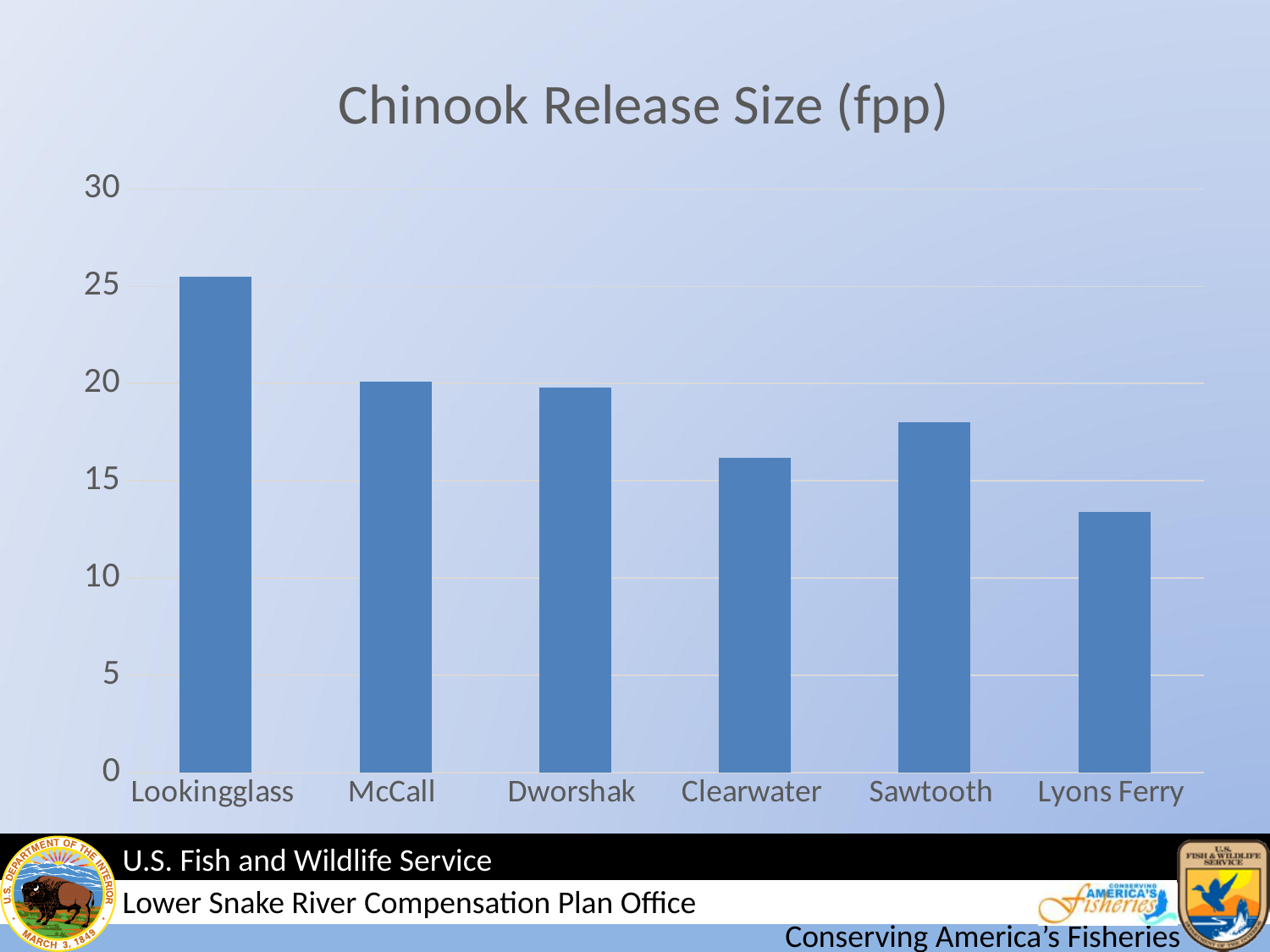
What kind of chart is shown on the slide? bar chart Is the value for Clearwater greater or less than 15? greater Which has a larger release size, Lookingglass or McCall? Lookingglass What is the highest value shown on the y axis? 30 Is the value for Lookingglass greater or less than 20? greater Which has a larger release size, Sawtooth or Clearwater? Sawtooth Is the value for Lyons Ferry greater or less than 15? less How many hatcheries (categories) are shown on the x axis? 6 Which hatchery has the smallest Chinook release size? Lyons Ferry What is the title of the chart? Chinook Release Size (fpp) Which hatchery has the largest Chinook release size? Lookingglass